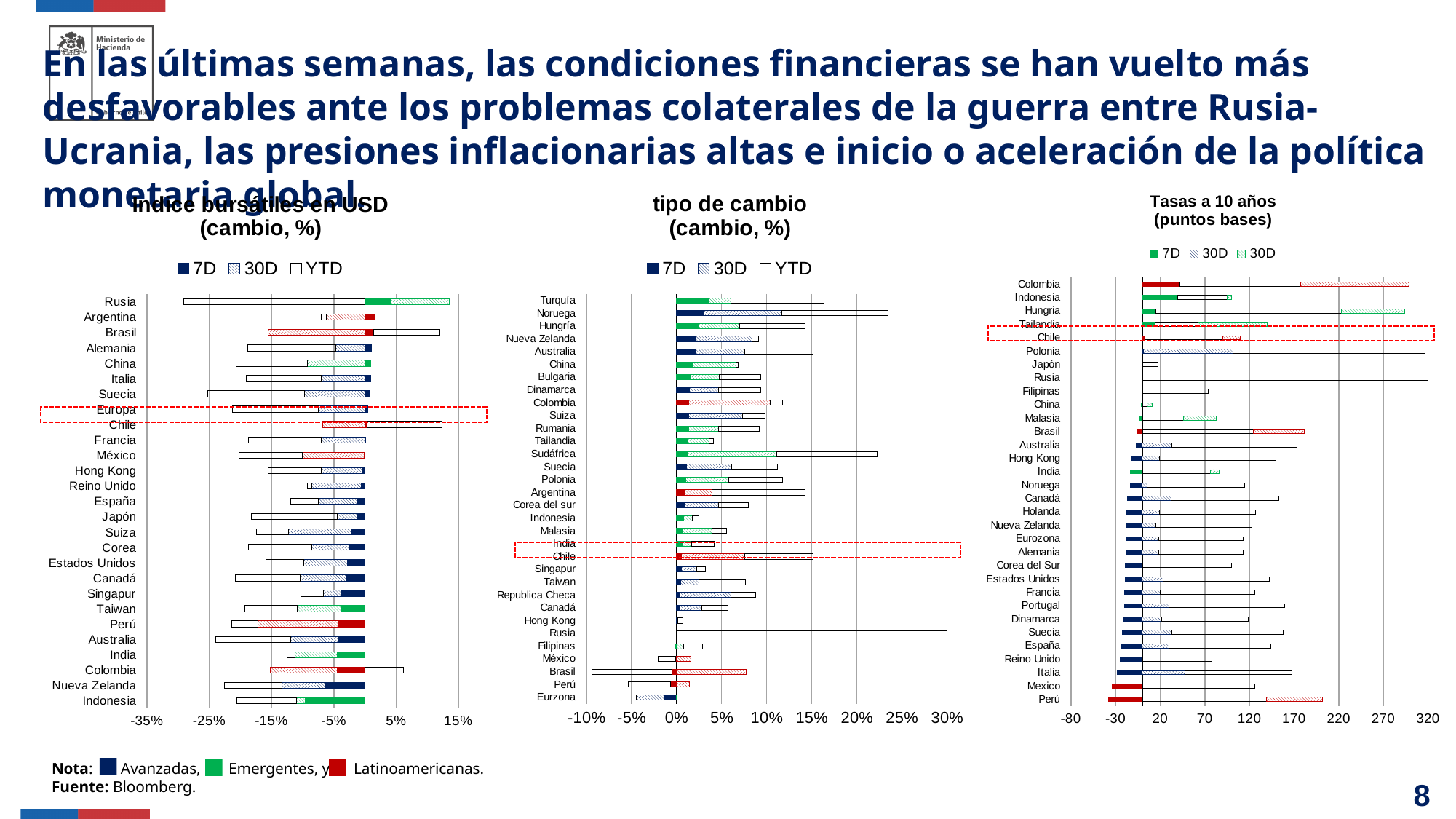
In the 'tipo de cambio (cambio, %)' chart, which country has the highest YTD value? Rusia How many countries/regions are listed on the 'Índice bursátiles en USD (cambio, %)' chart? 27 How many series does the legend of the 'tipo de cambio (cambio, %)' chart list? 3 According to the note on the slide, which group of countries do the red bars represent? Latinoamericanas In the 'tipo de cambio (cambio, %)' chart, is the YTD value for Brasil greater or less than -5%? less In the 'Índice bursátiles en USD (cambio, %)' chart, which country has the lowest YTD value? Rusia What kind of chart is the 'Índice bursátiles en USD (cambio, %)' chart on the left? Bar chart How many countries/regions are listed on the 'tipo de cambio (cambio, %)' chart? 32 In the 'Índice bursátiles en USD (cambio, %)' chart, is the YTD value for Rusia greater or less than -25%? less How many countries/regions are listed on the 'Tasas a 10 años (puntos bases)' chart? 32 In the 'tipo de cambio (cambio, %)' chart, is the YTD value for Rusia greater or less than 25%? greater